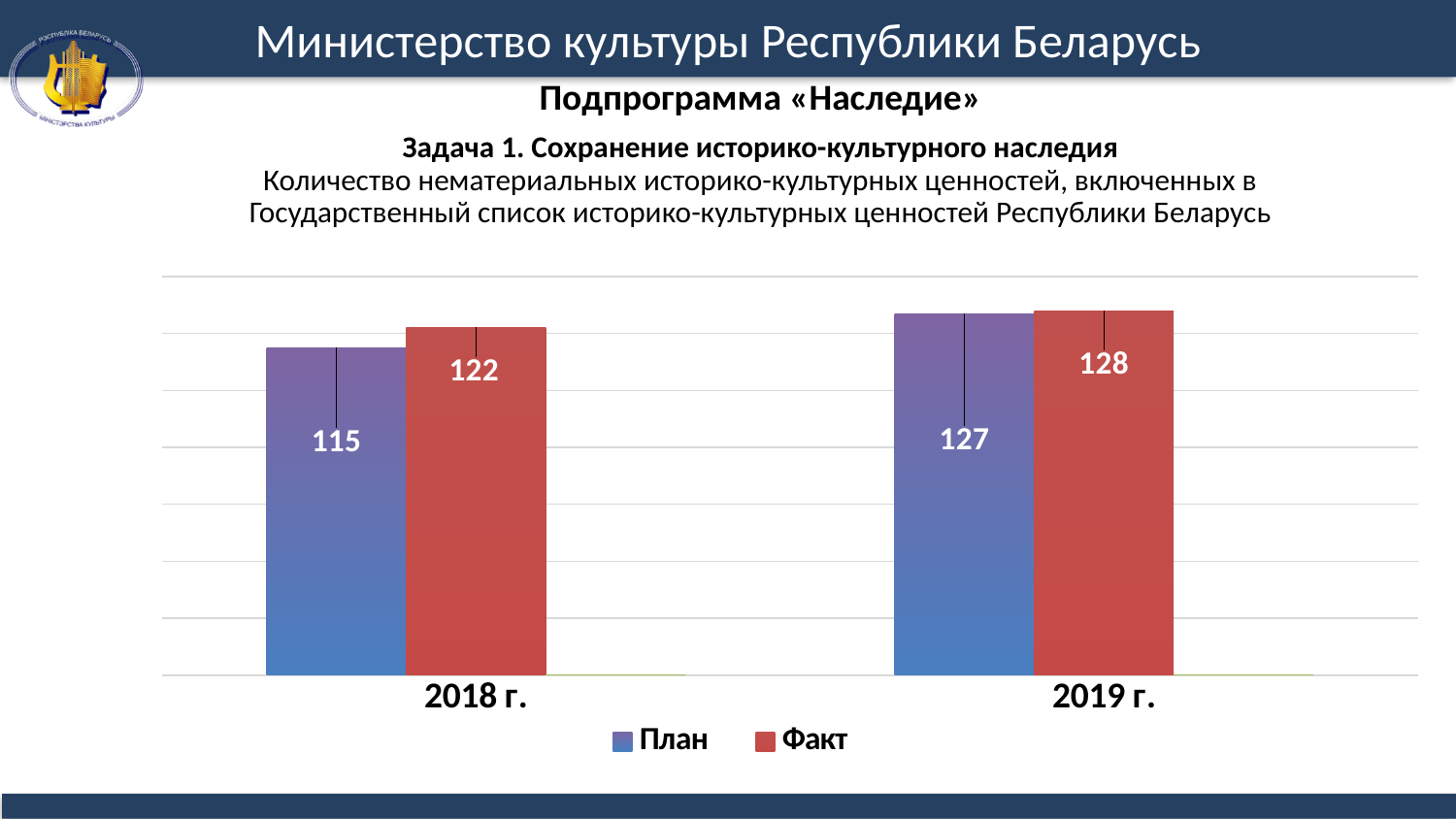
By how much did План increase from 2018 г. to 2019 г.? 12 What kind of chart is shown on the slide? Bar chart Which year has the higher Факт value? 2019 г. What is the value of План for 2018 г.? 115 What is the value of Факт for 2018 г.? 122 Which is larger in 2019 г., План or Факт? Факт How many series does the legend list? 2 What is the value of План for 2019 г.? 127 Which year has the lowest План value? 2018 г. What is the difference between Факт and План in 2018 г.? 7 Does the Факт value rise or fall from 2018 г. to 2019 г.? Rise What is the value of Факт for 2019 г.? 128